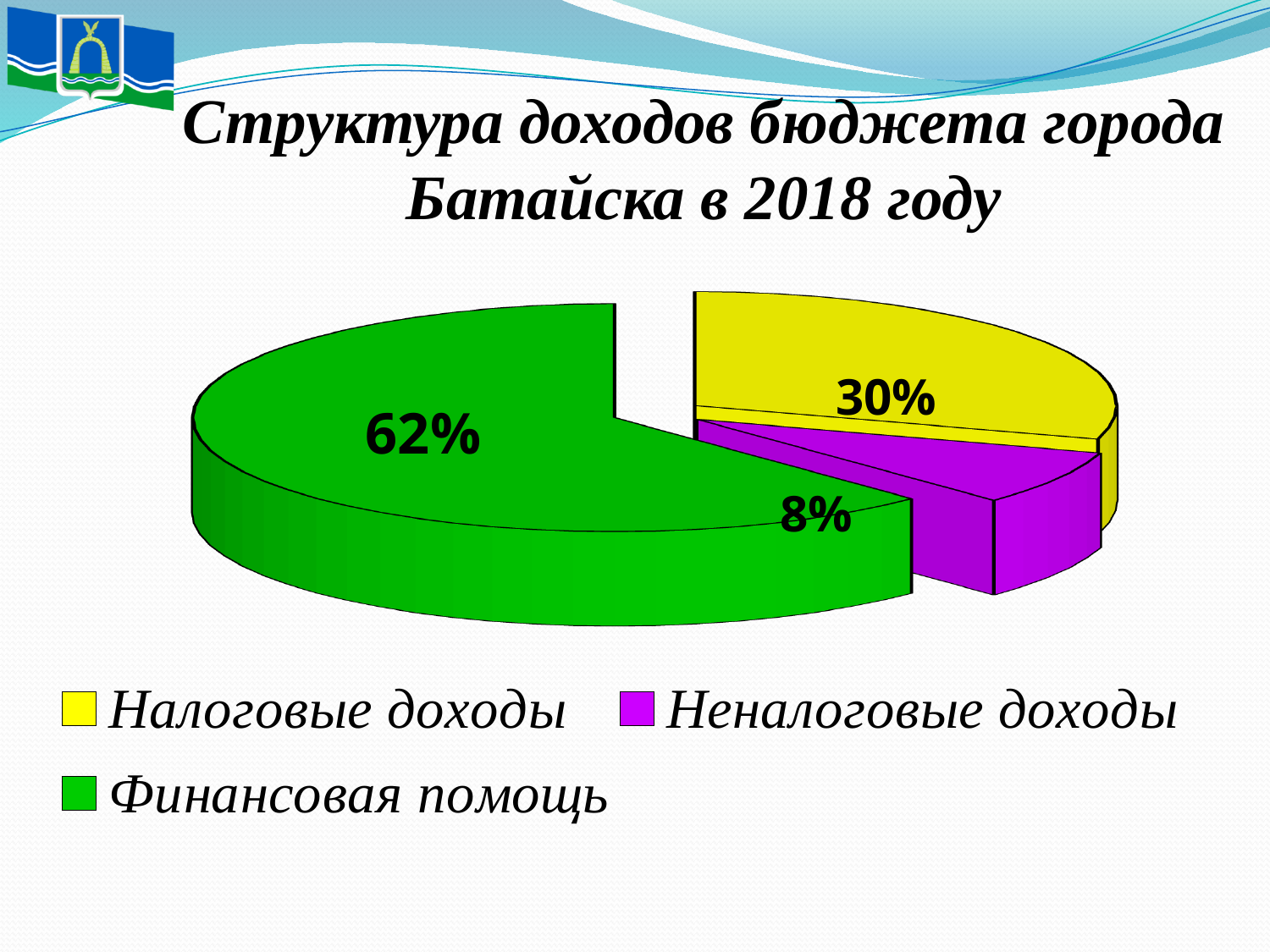
What share of the pie does Налоговые доходы represent? 30% Which category has the smallest share of the pie? Неналоговые доходы Which category has the largest share of the pie? Финансовая помощь What is the difference in percentage points between Финансовая помощь and Налоговые доходы? 32 What share of the pie does Финансовая помощь represent? 62% What kind of chart is shown on the slide? Pie chart Which is larger, the share for Налоговые доходы or the share for Неналоговые доходы? Налоговые доходы What share of the pie does Неналоговые доходы represent? 8% How many categories does the pie chart show? 3 What is the difference in percentage points between Налоговые доходы and Неналоговые доходы? 22 What is the title of the chart? Структура доходов бюджета города Батайска в 2018 году What colour represents Неналоговые доходы in the pie chart? Purple